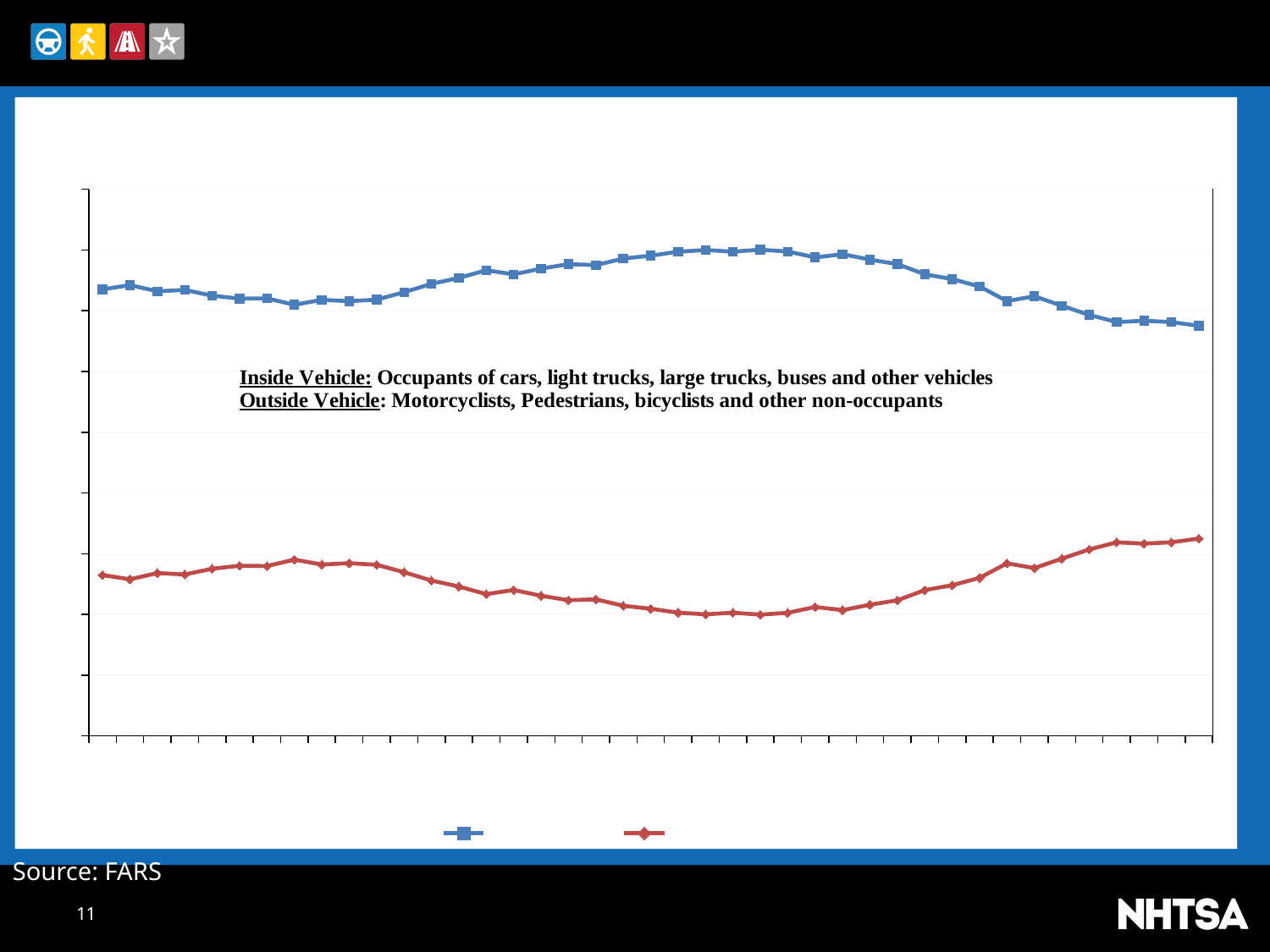
Does the blue series rise or fall from the left side of the chart toward its peak in the middle? rise What kind of chart is shown on the slide? line chart What source is cited for the chart data? FARS Does the blue series rise or fall over the last several points on the right of the chart? fall Does the red series rise or fall over the last several points on the right of the chart? rise Which series has higher values throughout the chart, the blue series or the red series? the blue series What marker shape is used for the blue series? squares How many series does the legend list? 2